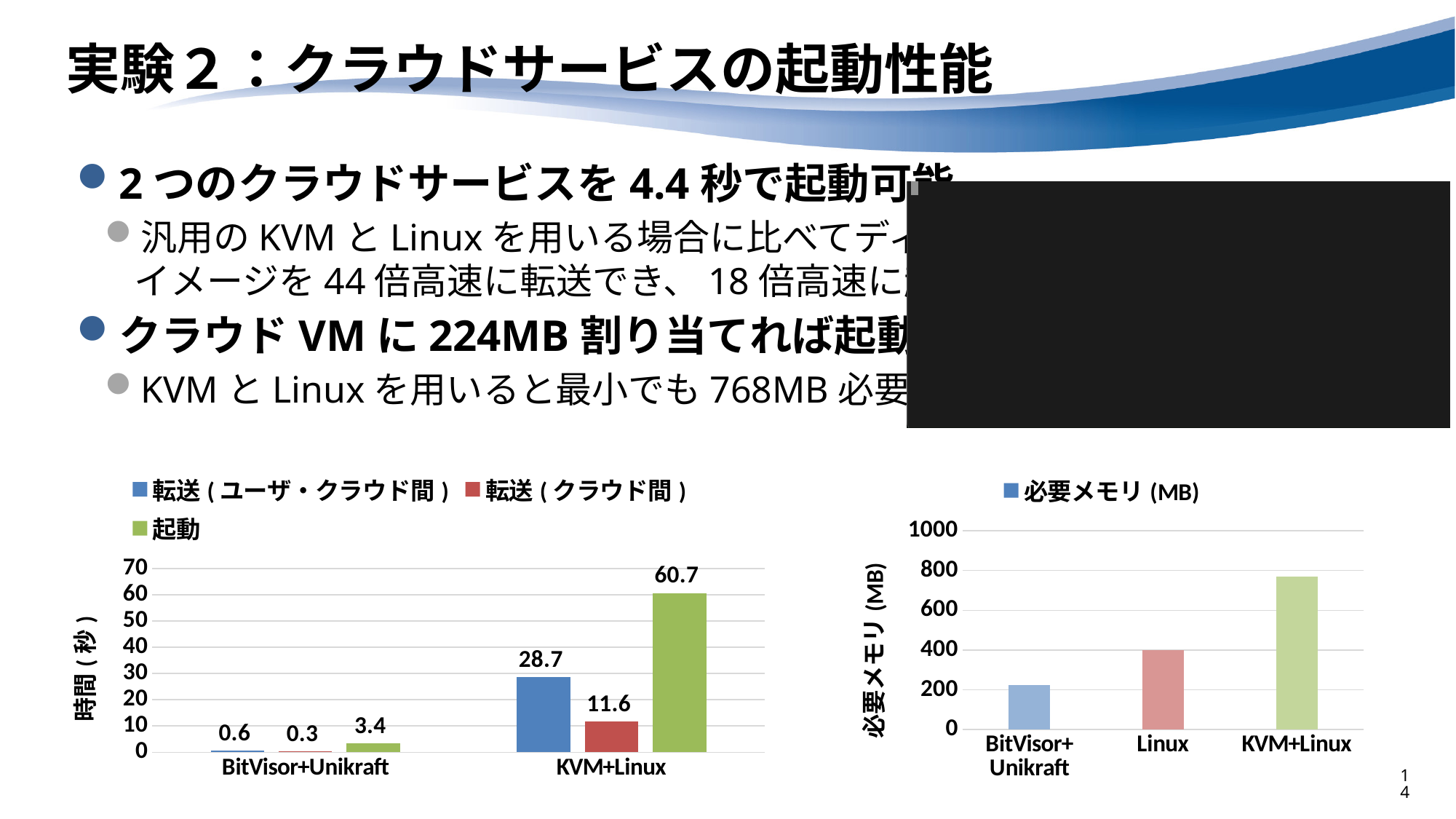
How many series does the legend of the left chart list? 3 In the right chart (必要メモリ (MB)), is the value for KVM+Linux greater or less than 600? greater In the right chart (必要メモリ (MB)), which category has the highest value? KVM+Linux What kind of chart is the right chart (必要メモリ (MB))? bar chart In the left chart, which series has the highest value for KVM+Linux? 起動 In the left chart, what is the 起動 value for BitVisor+Unikraft? 3.4 In the right chart (必要メモリ (MB)), is the value for BitVisor+Unikraft greater or less than 400? less In the left chart, which series has the lowest value for BitVisor+Unikraft? 転送 ( クラウド間 ) In the left chart, what is the 転送 ( ユーザ・クラウド間 ) value for BitVisor+Unikraft? 0.6 In the left chart, what is the 起動 value for KVM+Linux? 60.7 In the left chart, what is the 転送 ( クラウド間 ) value for KVM+Linux? 11.6 In the left chart, what is the difference between the 転送 ( ユーザ・クラウド間 ) values for KVM+Linux and BitVisor+Unikraft? 28.1